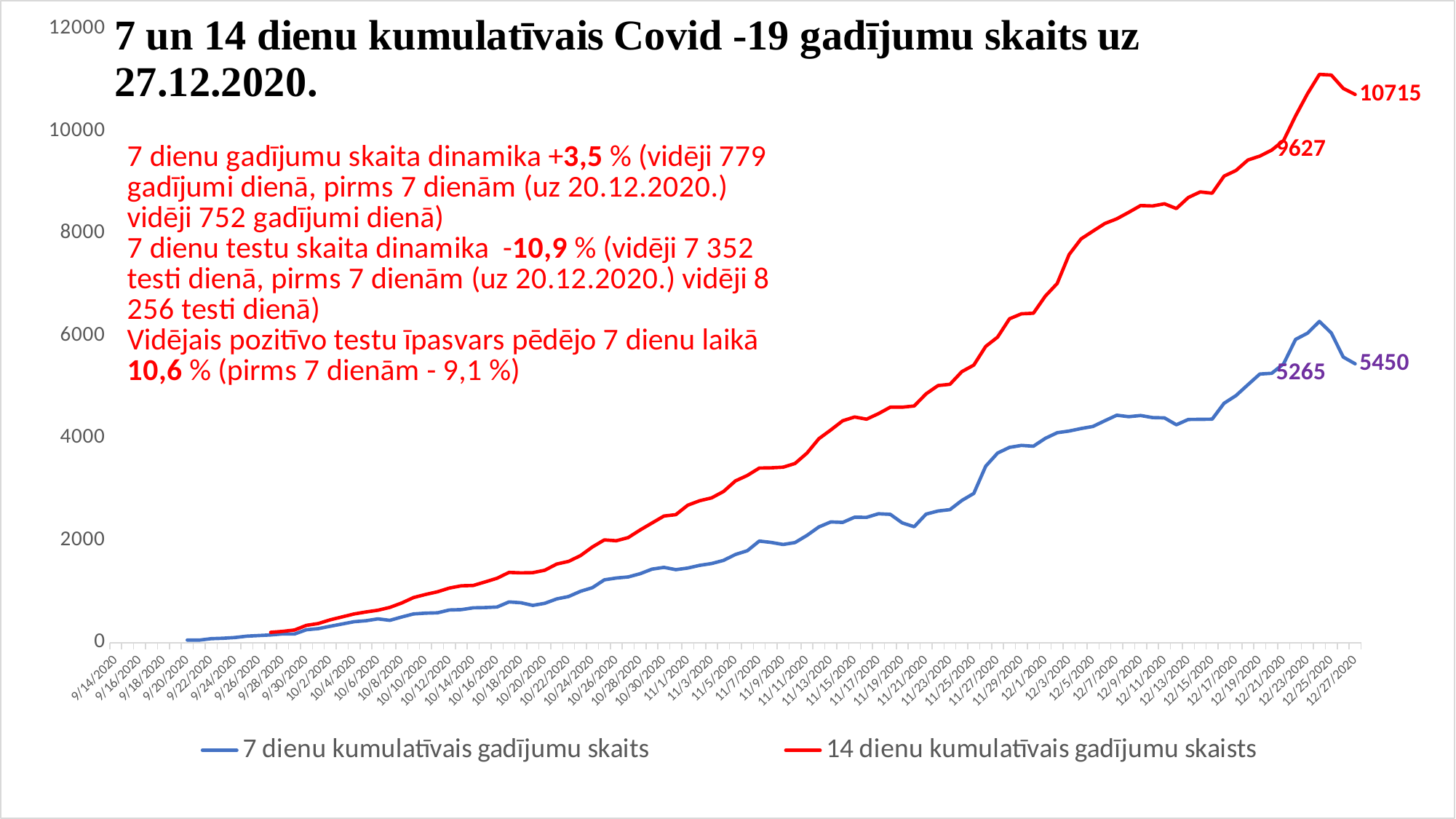
What is the value of the 14 dienu kumulatīvais gadījumu skaists series at the last point (12/27/2020)? 10715 What type of chart is shown on the slide? line chart How many series does the legend list? 2 What is the difference between the two labelled values at 12/27/2020 (10715 and 5450)? 5265 Is the value of the 14 dienu kumulatīvais gadījumu skaists series at 12/1/2020 greater or less than 6000? greater What is the highest value labelled on the chart? 10715 Is the value of the 7 dienu kumulatīvais gadījumu skaits series at 11/1/2020 greater or less than 2000? less Do the values of the 14 dienu kumulatīvais gadījumu skaists series generally rise or fall from 9/28/2020 to 12/27/2020? rise What is the value of the 7 dienu kumulatīvais gadījumu skaits series at the last point (12/27/2020)? 5450 What colour is the line for the 7 dienu kumulatīvais gadījumu skaits series? blue Which series has the higher value at 12/27/2020, the 7-day or the 14-day cumulative count? 14 dienu kumulatīvais gadījumu skaists What is the difference between the two labelled values on the red line, 10715 and 9627? 1088